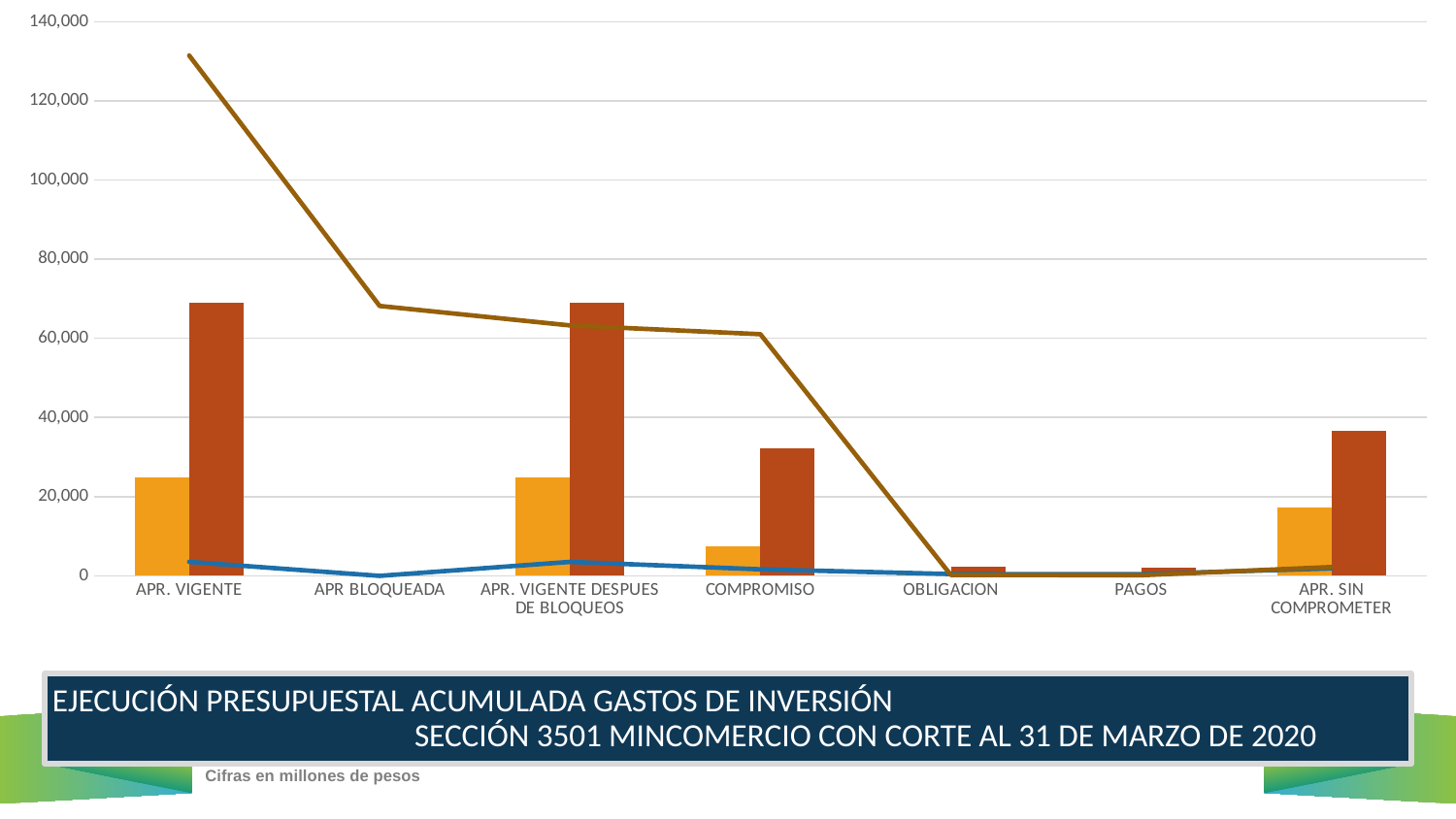
Is the value of the dark red bar for APR. VIGENTE greater or less than 60,000? greater Is the value of the dark red bar for COMPROMISO greater or less than 40,000? less How many categories are shown on the x axis of the chart? 7 Is the value of the dark red bar for APR. VIGENTE greater or less than 80,000? less What kind of chart is shown on the slide? A combination bar and line chart Which has the larger orange bar, COMPROMISO or APR. SIN COMPROMETER? APR. SIN COMPROMETER Does the brown line rise or fall from APR. VIGENTE to OBLIGACION? It falls Which category has no bars plotted at all? APR BLOQUEADA According to the note below the chart, in what units are the figures expressed? Millones de pesos